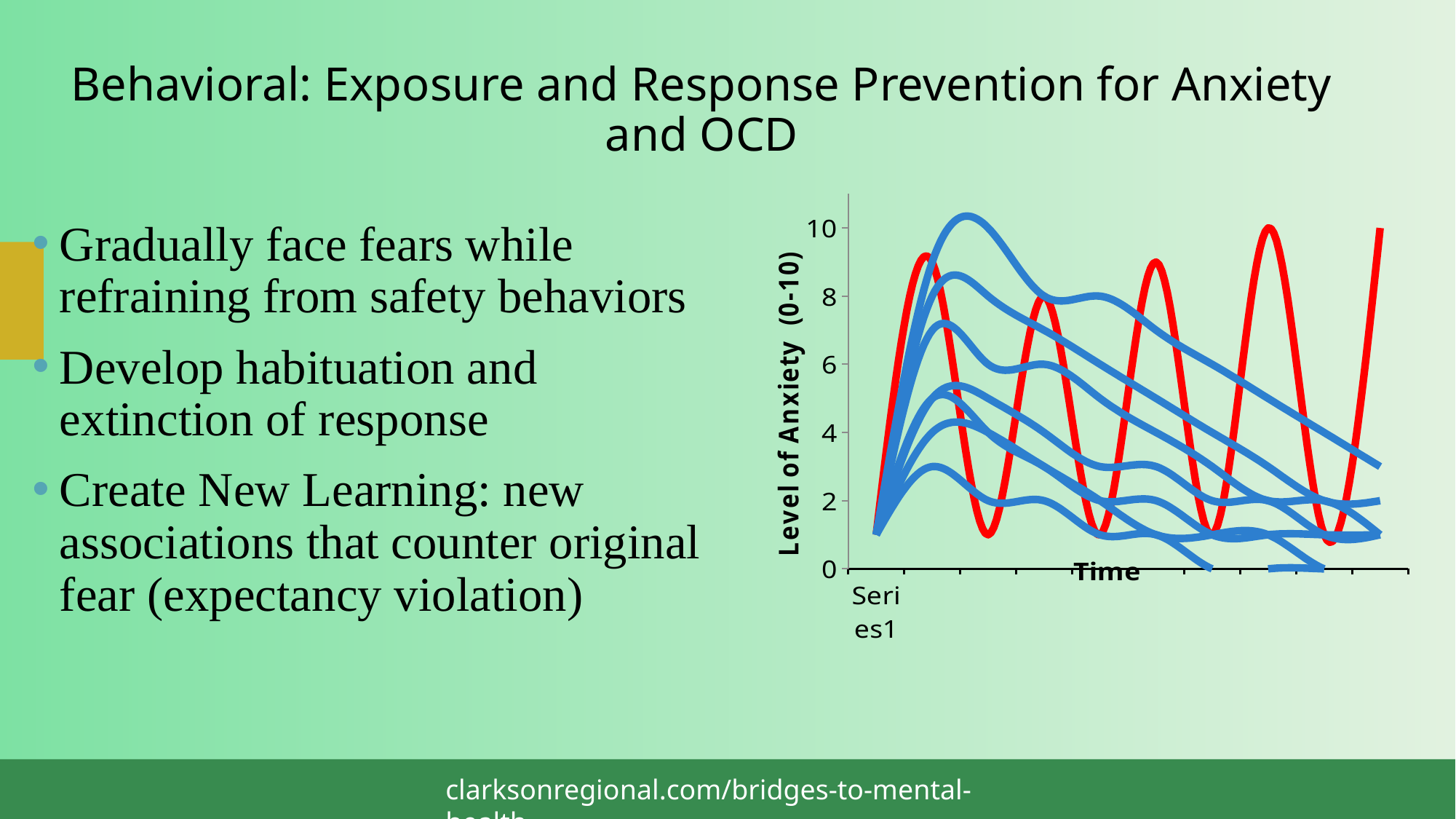
Does the red line show a steady decline over time, or does it repeatedly rise and fall? repeatedly rises and falls Do the blue lines in the chart generally rise or fall as time increases? fall Is the highest peak of the red line greater or less than 8? greater Is the lowest trough of the red line greater or less than 2? less How many tick labels are shown on the vertical axis of the chart? 6 Is the highest peak reached by any blue line greater or less than 8? greater What is the highest value labelled on the vertical axis of the chart? 10 What kind of chart is shown on the slide? line chart What is the title of the horizontal axis of the chart? Time What is the title of the vertical axis of the chart? Level of Anxiety (0-10)